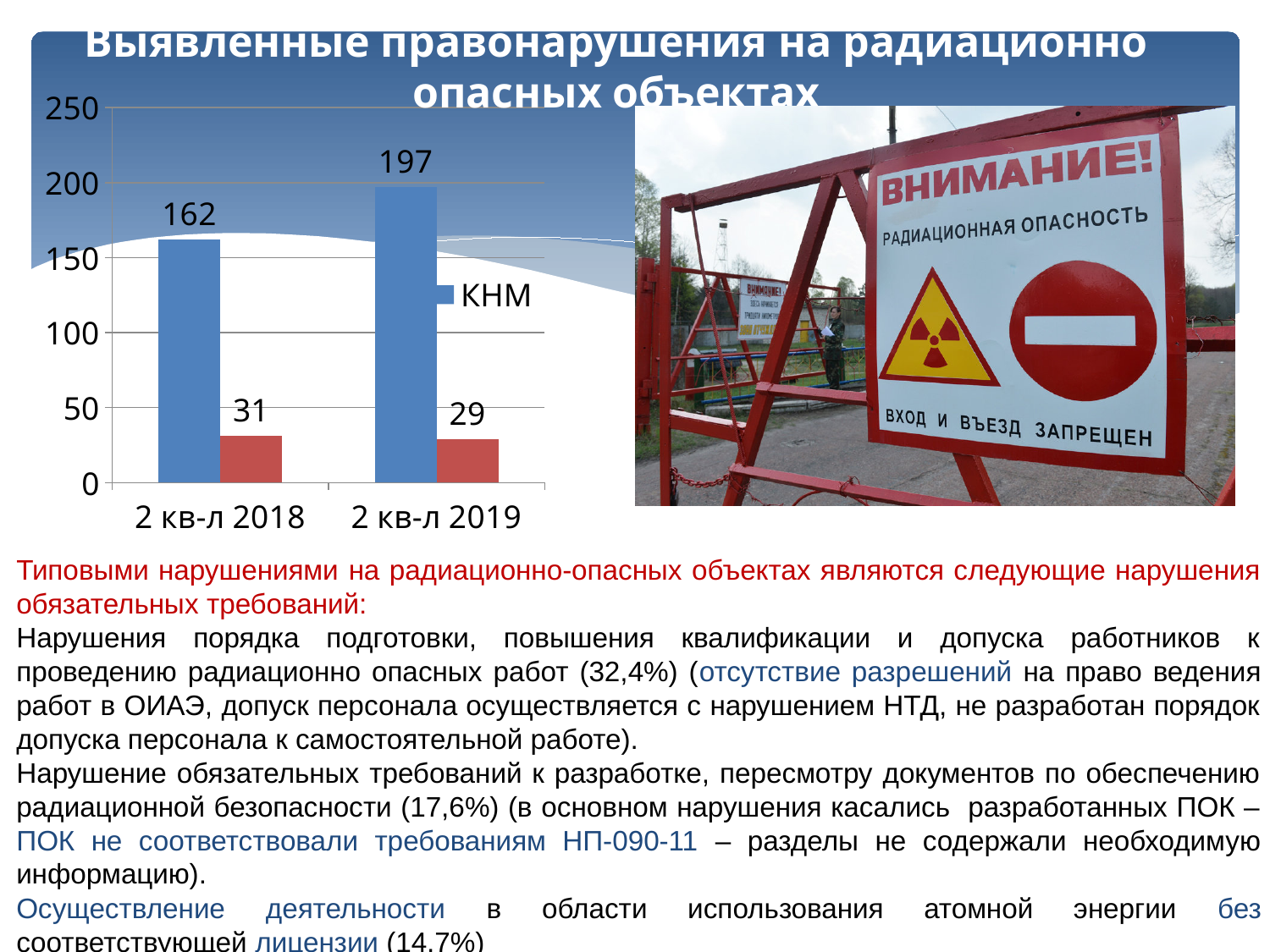
What value is labelled on the red bar for 2 кв-л 2019? 29 Which period has the higher КНМ value, 2 кв-л 2018 or 2 кв-л 2019? 2 кв-л 2019 What is the value of the КНМ series for 2 кв-л 2019? 197 Does the КНМ value rise or fall from 2 кв-л 2018 to 2 кв-л 2019? rise What series name is shown in the visible legend entry of the chart? КНМ What value is labelled on the red bar for 2 кв-л 2018? 31 What is the difference between the red bar values for 2 кв-л 2018 and 2 кв-л 2019? 2 Is the КНМ value for 2 кв-л 2019 greater or less than 150? greater What is the value of the КНМ series for 2 кв-л 2018? 162 How many periods (categories) are shown on the x axis of the chart? 2 By how much did the КНМ value increase from 2 кв-л 2018 to 2 кв-л 2019? 35 What type of chart is shown on the slide? bar chart